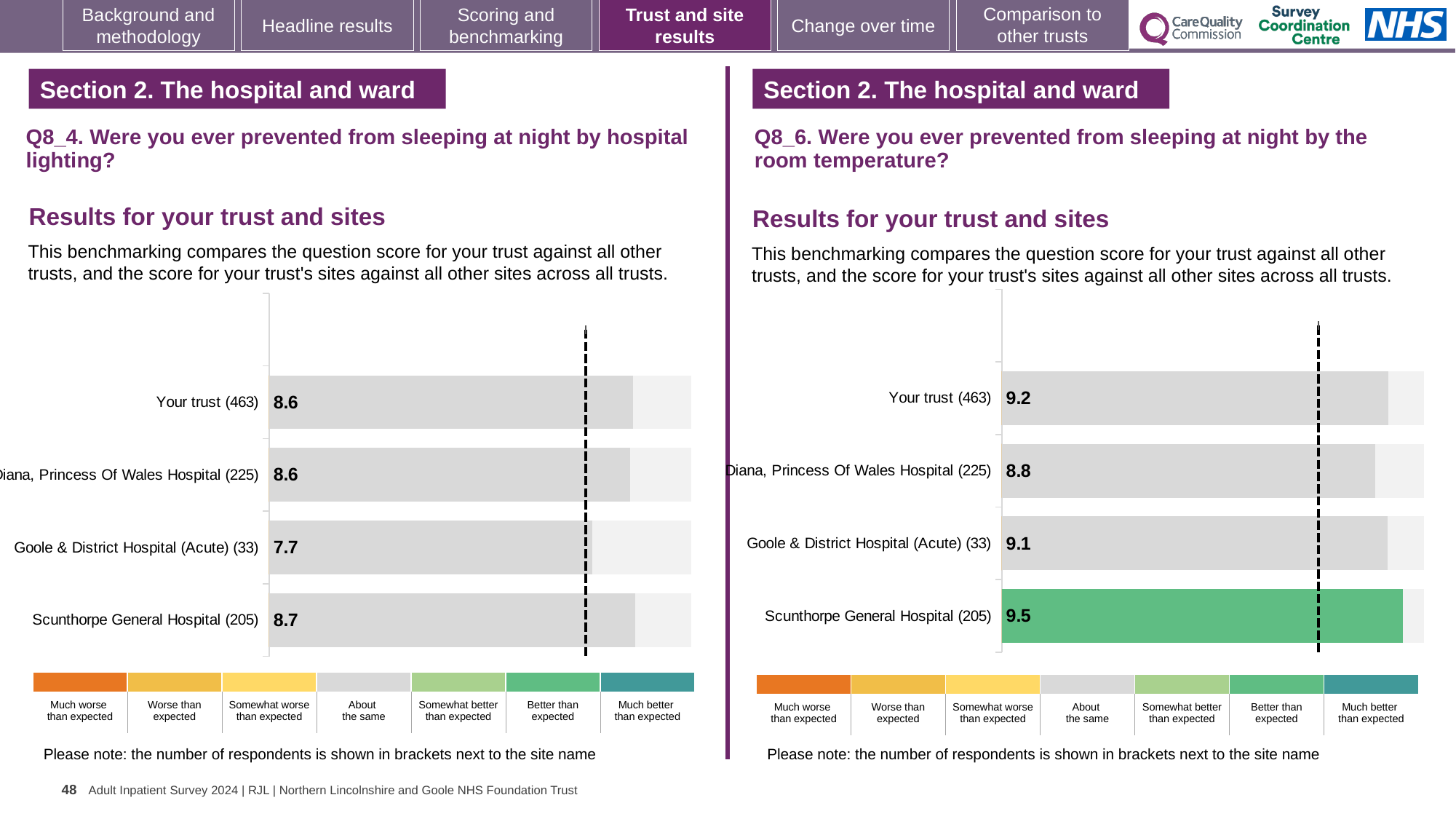
In the Q8_4 hospital lighting chart, what is the score for Your trust (463)? 8.6 In the Q8_4 hospital lighting chart, what is the score for Goole & District Hospital (Acute) (33)? 7.7 In the Q8_6 room temperature chart, what is the score for Diana, Princess Of Wales Hospital (225)? 8.8 In the Q8_4 hospital lighting chart, what is the difference between the scores for Scunthorpe General Hospital (205) and Goole & District Hospital (Acute) (33)? 1.0 In the Q8_4 hospital lighting chart, which site has the lowest score? Goole & District Hospital (Acute) (33) In the Q8_6 room temperature chart, what is the score for Scunthorpe General Hospital (205)? 9.5 In the Q8_6 room temperature chart, which benchmark category does the green colour of the Scunthorpe General Hospital (205) bar represent? Better than expected In the Q8_6 room temperature chart, which site has the highest score? Scunthorpe General Hospital (205) In the Q8_6 room temperature chart, which has the higher score: Goole & District Hospital (Acute) (33) or Scunthorpe General Hospital (205)? Scunthorpe General Hospital (205) In the Q8_6 room temperature chart, which site has the lowest score? Diana, Princess Of Wales Hospital (225) In the Q8_6 room temperature chart, what is the difference between the scores for Your trust (463) and Diana, Princess Of Wales Hospital (225)? 0.4 How many bars are shown in the Q8_4 hospital lighting chart? 4